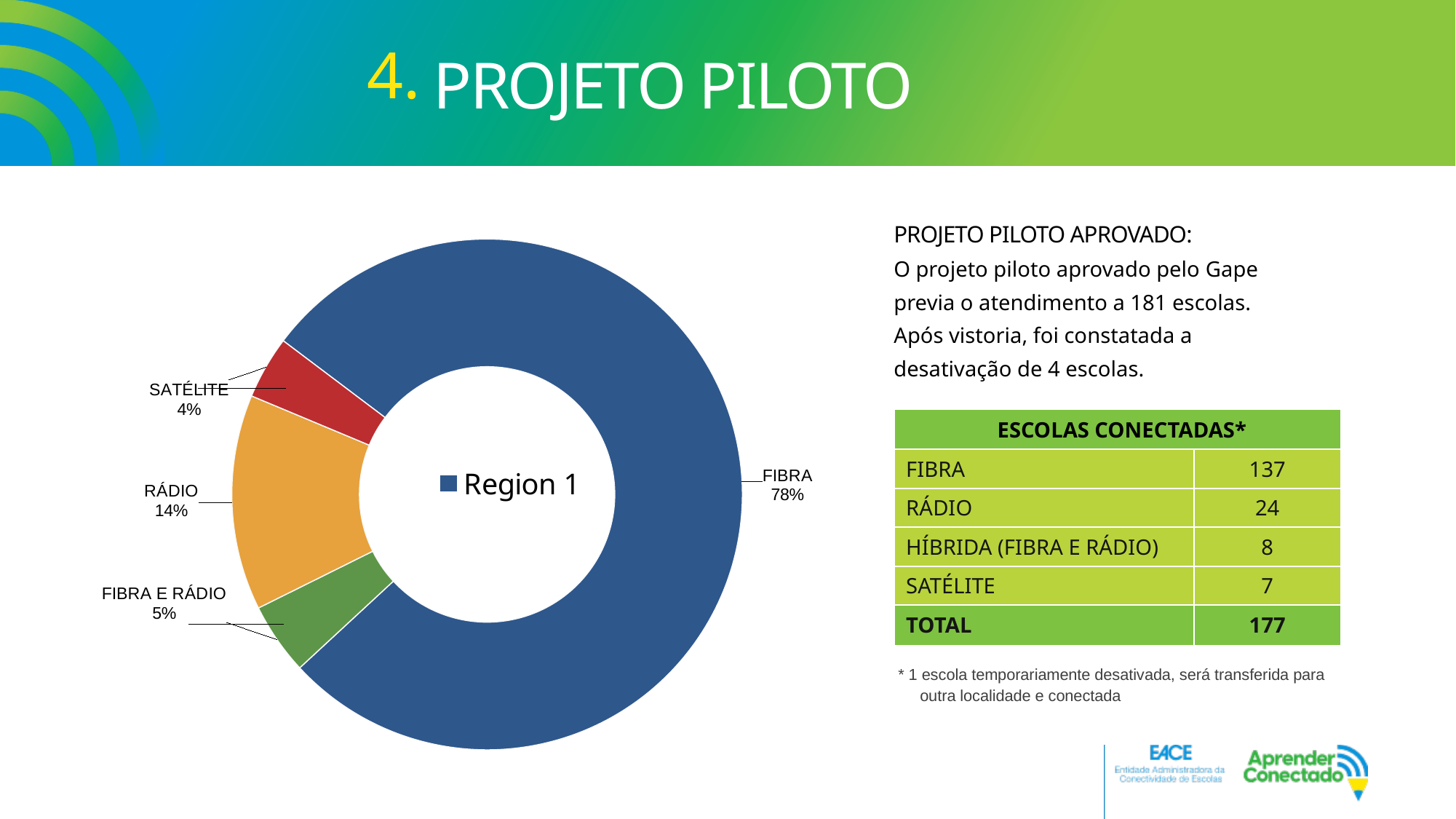
What legend entry is shown in the centre of the chart? Region 1 What is the difference in percentage points between the FIBRA share and the RÁDIO share? 64 How many categories are shown in the chart? 4 What percentage share does SATÉLITE have in the chart? 4% What percentage share does RÁDIO have in the chart? 14% What kind of chart is shown on the slide? Doughnut chart What percentage share does FIBRA have in the chart? 78% Which category has the largest share in the chart? FIBRA Which category has the smallest share in the chart? SATÉLITE What colour is the FIBRA slice in the chart? Blue What percentage share does FIBRA E RÁDIO have in the chart? 5% Which has a larger share in the chart, RÁDIO or SATÉLITE? RÁDIO